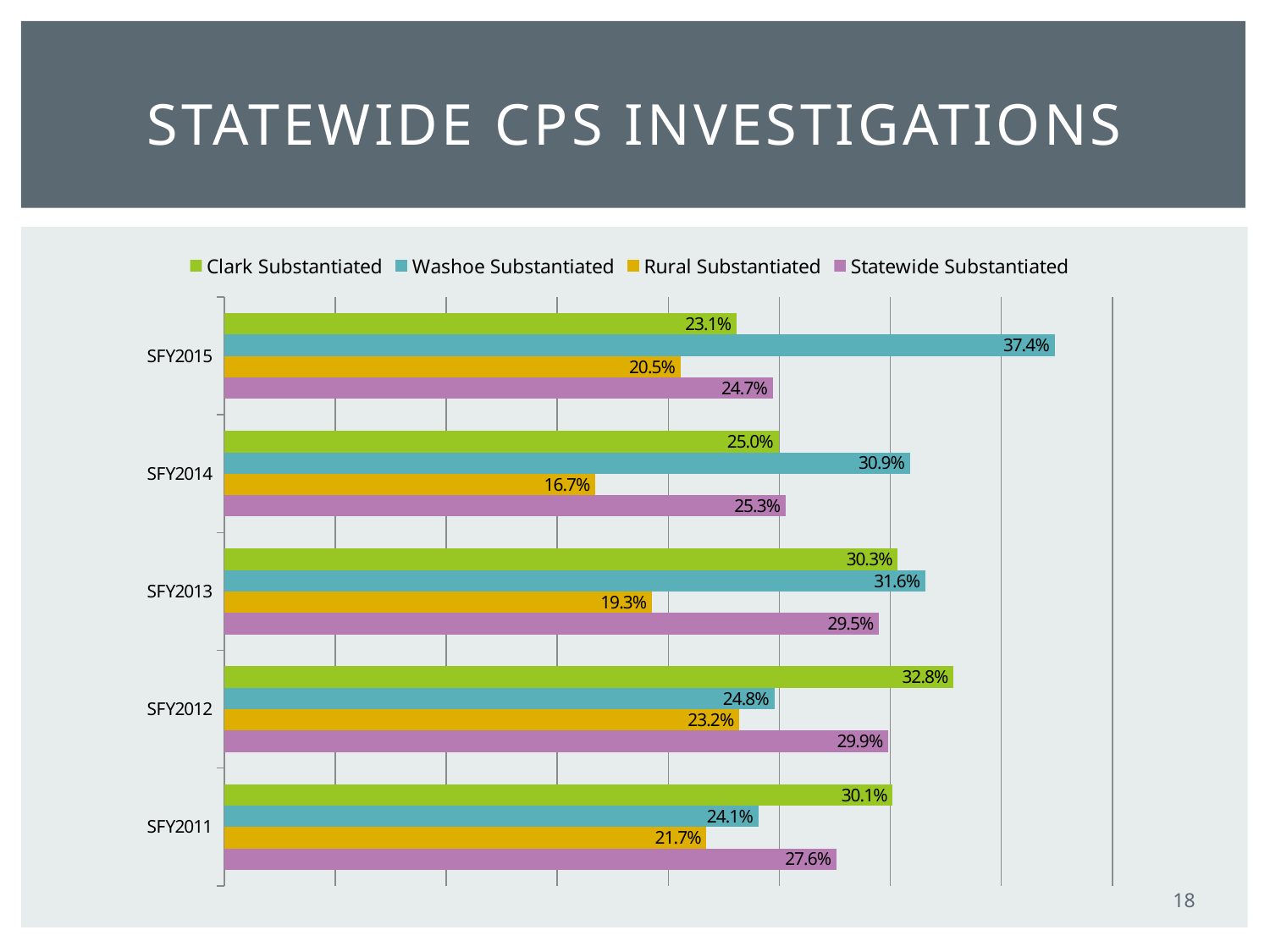
What is the Washoe Substantiated value for SFY2015? 37.4% What is the Rural Substantiated value for SFY2014? 16.7% What is the Clark Substantiated value for SFY2012? 32.8% Which fiscal year has the lowest Rural Substantiated value? SFY2014 What is the Statewide Substantiated value for SFY2011? 27.6% How many fiscal years are shown on the chart? 5 What is the title of the slide? STATEWIDE CPS INVESTIGATIONS What kind of chart is shown on the slide? Bar chart What is the difference between the Washoe Substantiated and Clark Substantiated values for SFY2015? 14.3% Which fiscal year has the highest Washoe Substantiated value? SFY2015 Which is larger for SFY2013: Clark Substantiated or Rural Substantiated? Clark Substantiated How many series does the legend list? 4